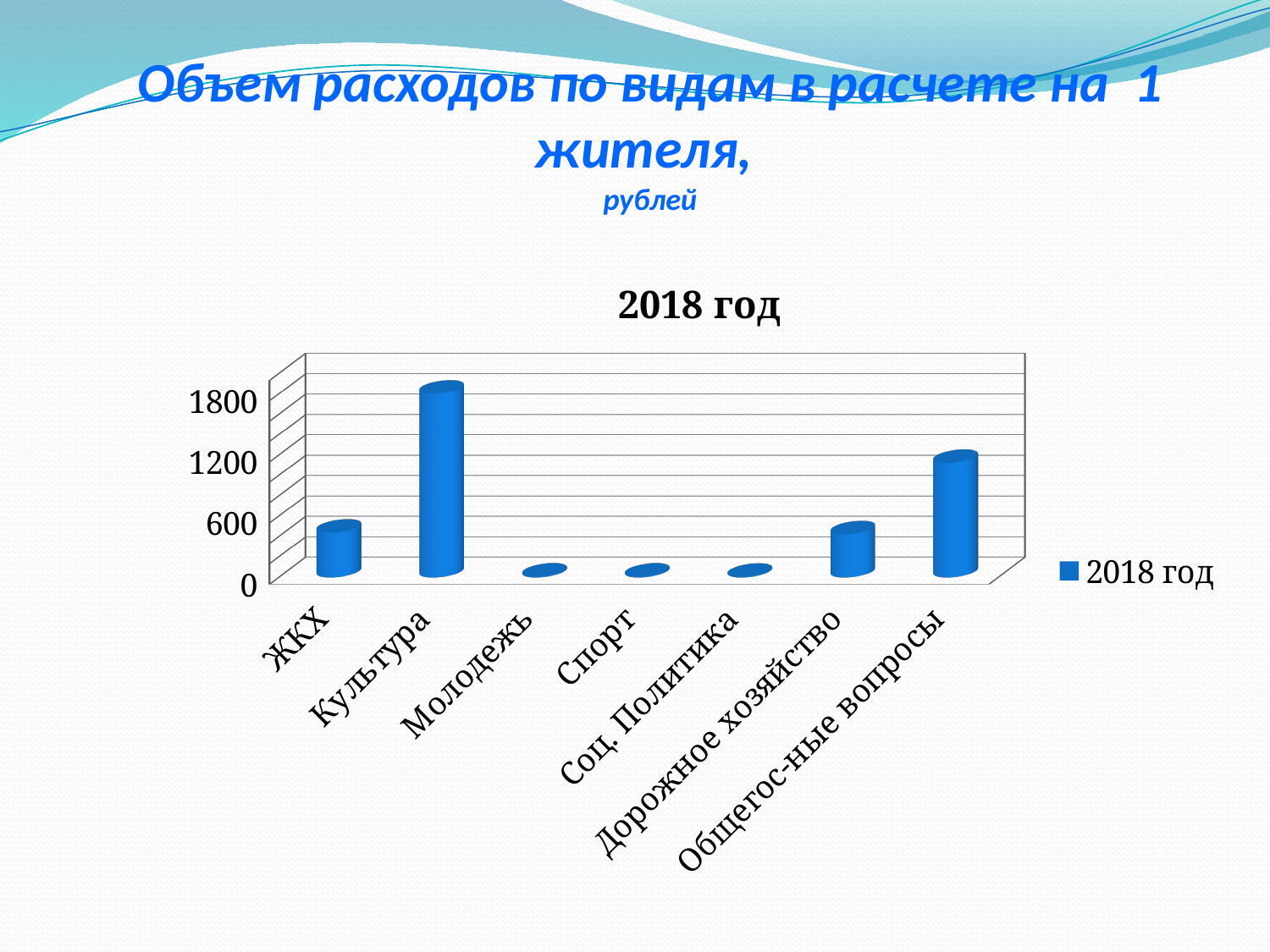
What entry is shown in the chart legend? 2018 год Which is larger, the value for Общегос-ные вопросы or the value for ЖКХ? Общегос-ные вопросы Which category has the highest value in the chart? Культура What kind of chart is shown on the slide? bar chart Is the value for Молодежь greater or less than 600? less Is the value for Общегос-ные вопросы greater or less than 600? greater What is the title of the chart? 2018 год Which is larger, the value for Культура or the value for Общегос-ные вопросы? Культура Is the value for Культура greater or less than 1200? greater How many categories are shown on the x axis of the chart? 7 How many series does the chart legend list? 1